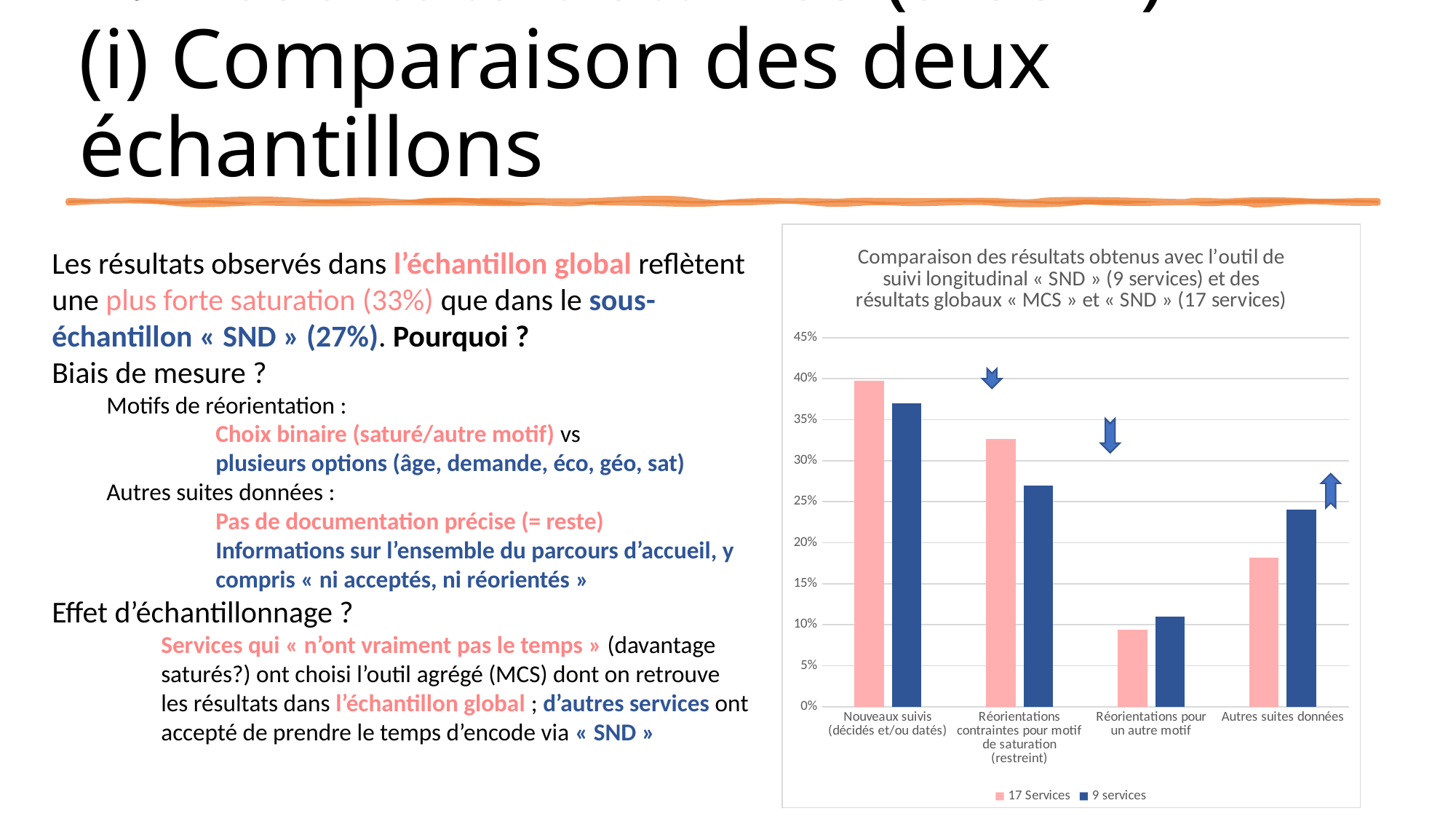
For Autres suites données, which series has the larger value, 17 Services or 9 services? 9 services Is the value for 17 Services in Réorientations pour un autre motif greater or less than 10%? less Is the value for 17 Services in Réorientations contraintes pour motif de saturation (restreint) greater or less than 30%? greater What kind of chart is shown on the slide? bar chart Which category has the lowest value for the 9 services series? Réorientations pour un autre motif How many series does the chart legend list? 2 Is the value for 9 services in Nouveaux suivis (décidés et/ou datés) greater or less than 35%? greater How many categories are shown on the x axis of the chart? 4 What are the two series names listed in the chart legend? 17 Services and 9 services Which category has the highest value for the 17 Services series? Nouveaux suivis (décidés et/ou datés) For Nouveaux suivis (décidés et/ou datés), which series has the larger value, 17 Services or 9 services? 17 Services